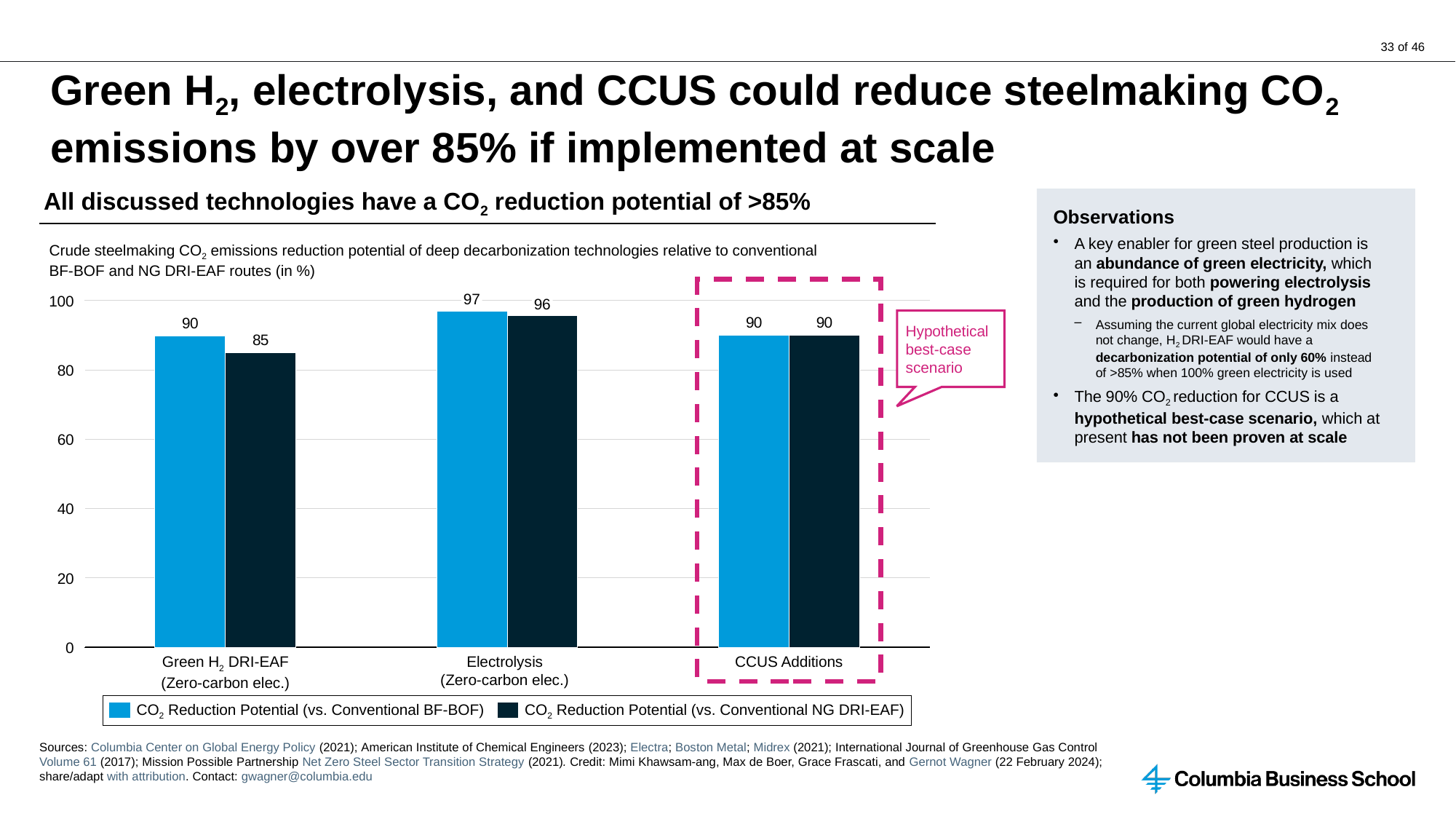
What kind of chart is shown on the slide? Bar chart What is the difference between the Electrolysis values vs. Conventional BF-BOF and vs. Conventional NG DRI-EAF? 1 Which technology has the lowest CO2 reduction potential vs. Conventional NG DRI-EAF? Green H2 DRI-EAF What is the CO2 reduction potential (vs. Conventional NG DRI-EAF) for CCUS Additions? 90 What is the CO2 reduction potential (vs. Conventional BF-BOF) for Electrolysis? 97 How many series does the legend list? 2 Which technology has the highest CO2 reduction potential vs. Conventional BF-BOF? Electrolysis How many technology categories are shown on the x axis? 3 Which category is enclosed by the dashed box labelled 'Hypothetical best-case scenario'? CCUS Additions What is the CO2 reduction potential (vs. Conventional NG DRI-EAF) for Green H2 DRI-EAF? 85 What is the CO2 reduction potential (vs. Conventional BF-BOF) for Green H2 DRI-EAF? 90 For Green H2 DRI-EAF, which is larger: the reduction potential vs. Conventional BF-BOF or vs. Conventional NG DRI-EAF? vs. Conventional BF-BOF